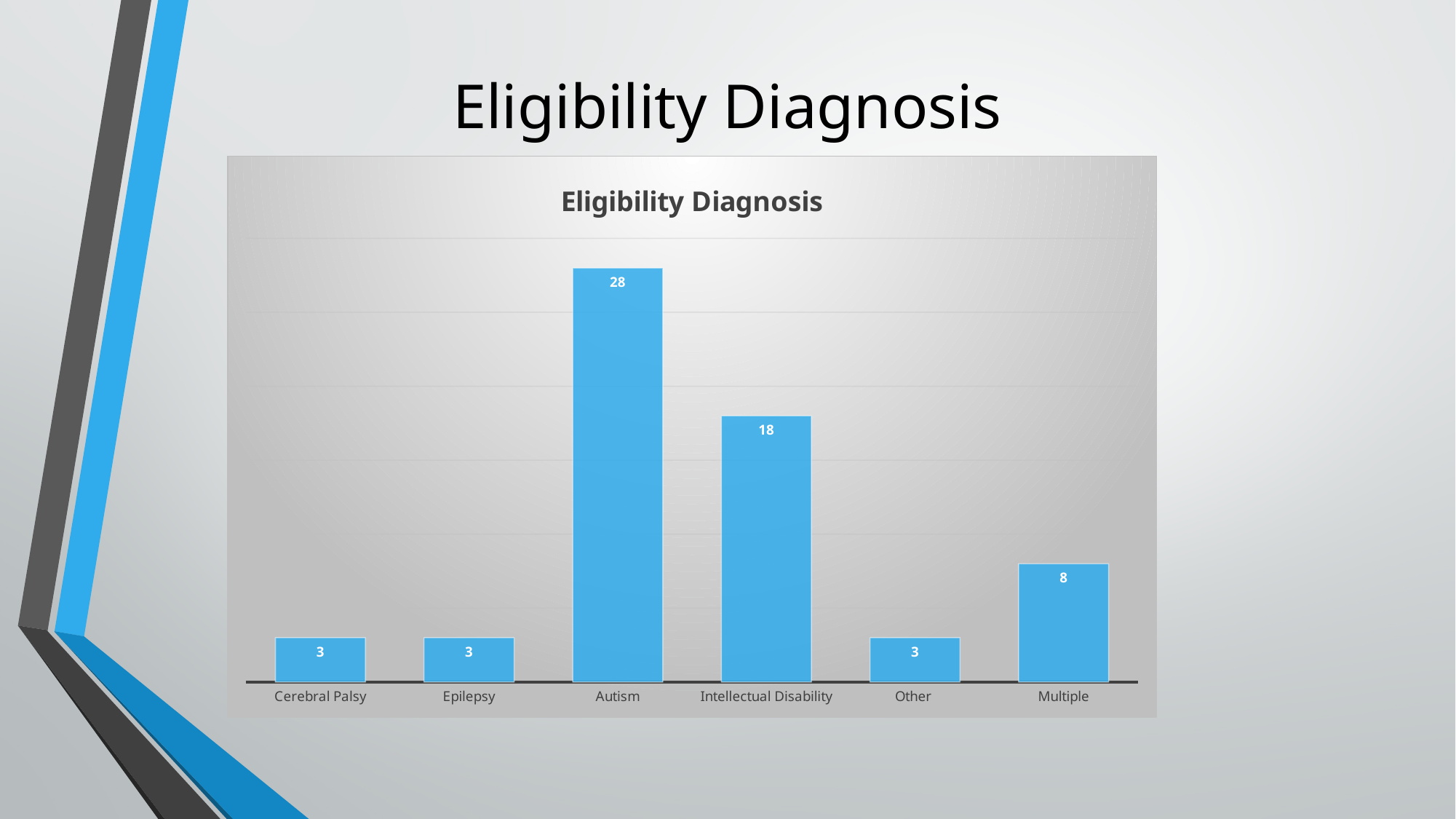
What kind of chart is shown? bar chart What is the value for Intellectual Disability? 18 How many categories have a value of 3? 3 What is the title of the chart? Eligibility Diagnosis Which category has the highest value? Autism What is the difference between the values for Multiple and Other? 5 Which is larger, the value for Intellectual Disability or the value for Multiple? Intellectual Disability What is the value for Multiple? 8 How many categories are shown on the x axis? 6 What is the value for Epilepsy? 3 What is the difference between the values for Autism and Intellectual Disability? 10 What is the value for Autism? 28